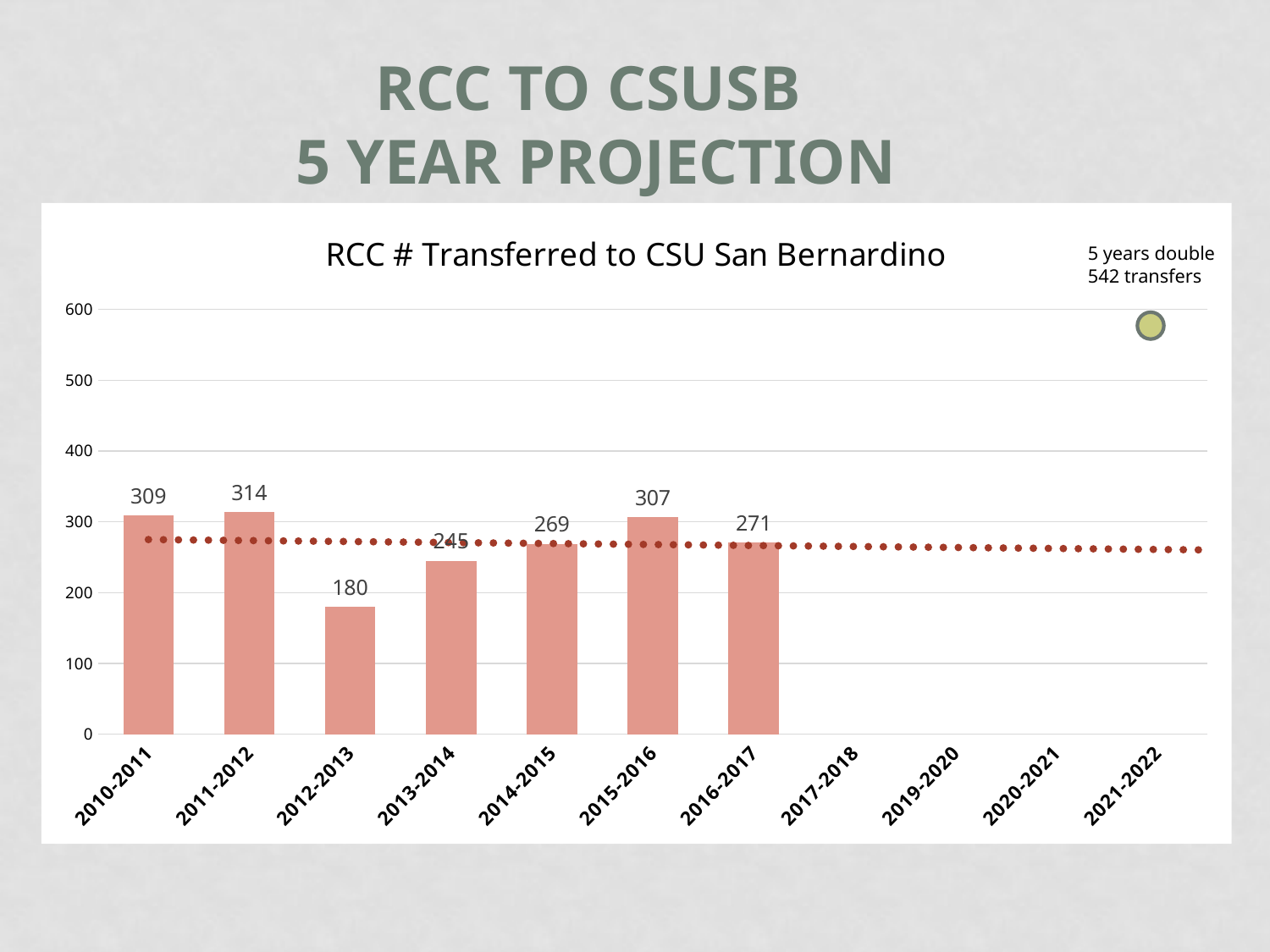
Which is larger, the value for 2013-2014 or the value for 2014-2015? 2014-2015 What is the value for 2010-2011 in the RCC # Transferred to CSU San Bernardino chart? 309 What is the title of the chart? RCC # Transferred to CSU San Bernardino What kind of chart is shown on the slide? Bar chart What is the value for 2012-2013? 180 What is the difference between the values for 2015-2016 and 2014-2015? 38 What is the value for 2016-2017? 271 Does the number of transfers rise or fall from 2011-2012 to 2012-2013? Fall How many bars with data values are plotted in the chart? 7 Which year has the highest number of transfers? 2011-2012 What is the difference between the values for 2011-2012 and 2012-2013? 134 Which year has the lowest number of transfers? 2012-2013